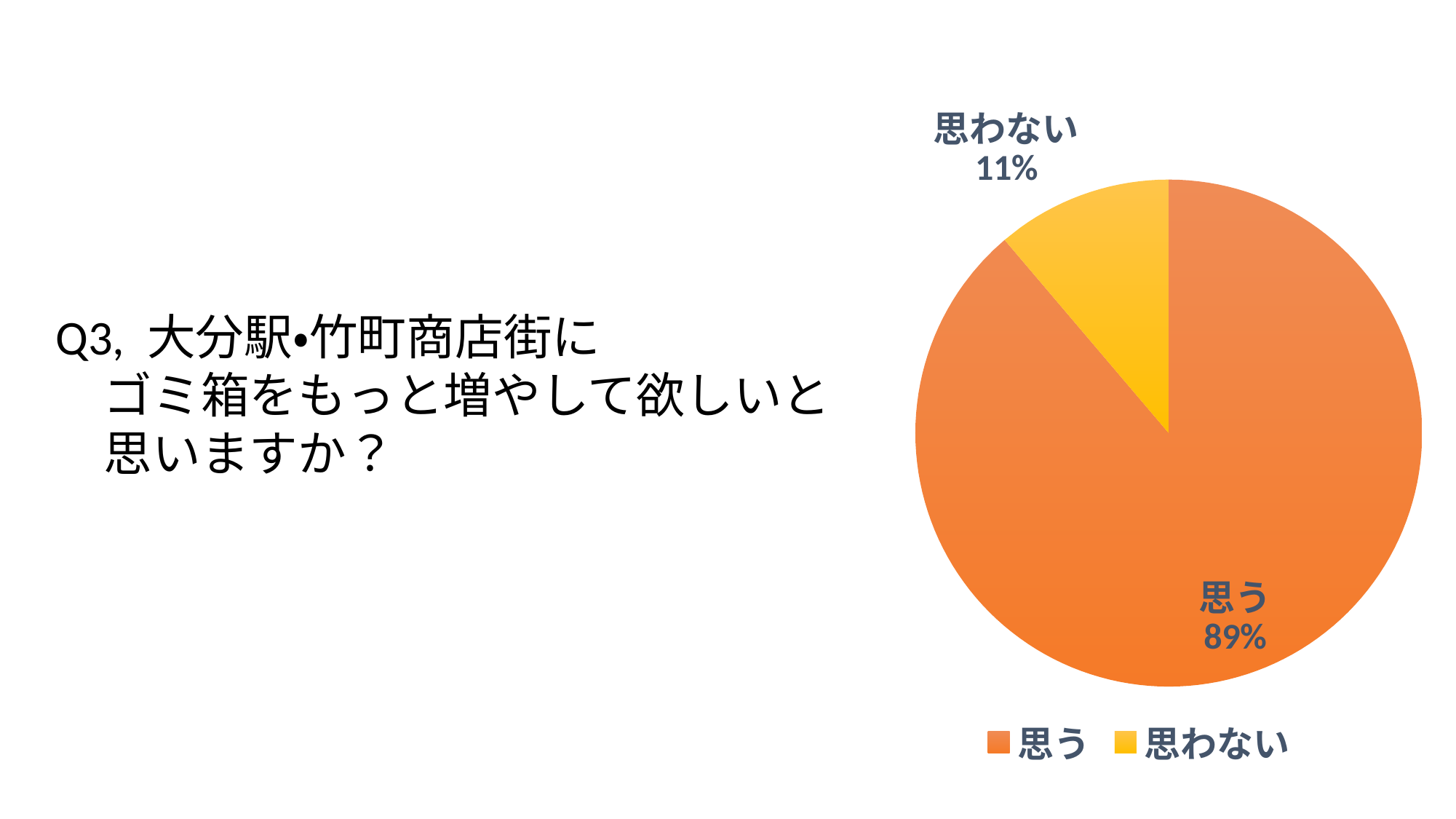
What share of the pie does 思う represent? 89% How many entries does the legend list? 2 Which category has the smallest slice of the pie? 思わない What is the difference in percentage points between 思う and 思わない? 78 How many slices does the pie chart have? 2 Where is the legend positioned relative to the pie chart? below the chart What share of the pie does 思わない represent? 11% Which category has the largest slice of the pie? 思う Which is larger, the share for 思う or the share for 思わない? 思う What kind of chart is shown on the slide? pie chart What colour is the 思わない slice? yellow